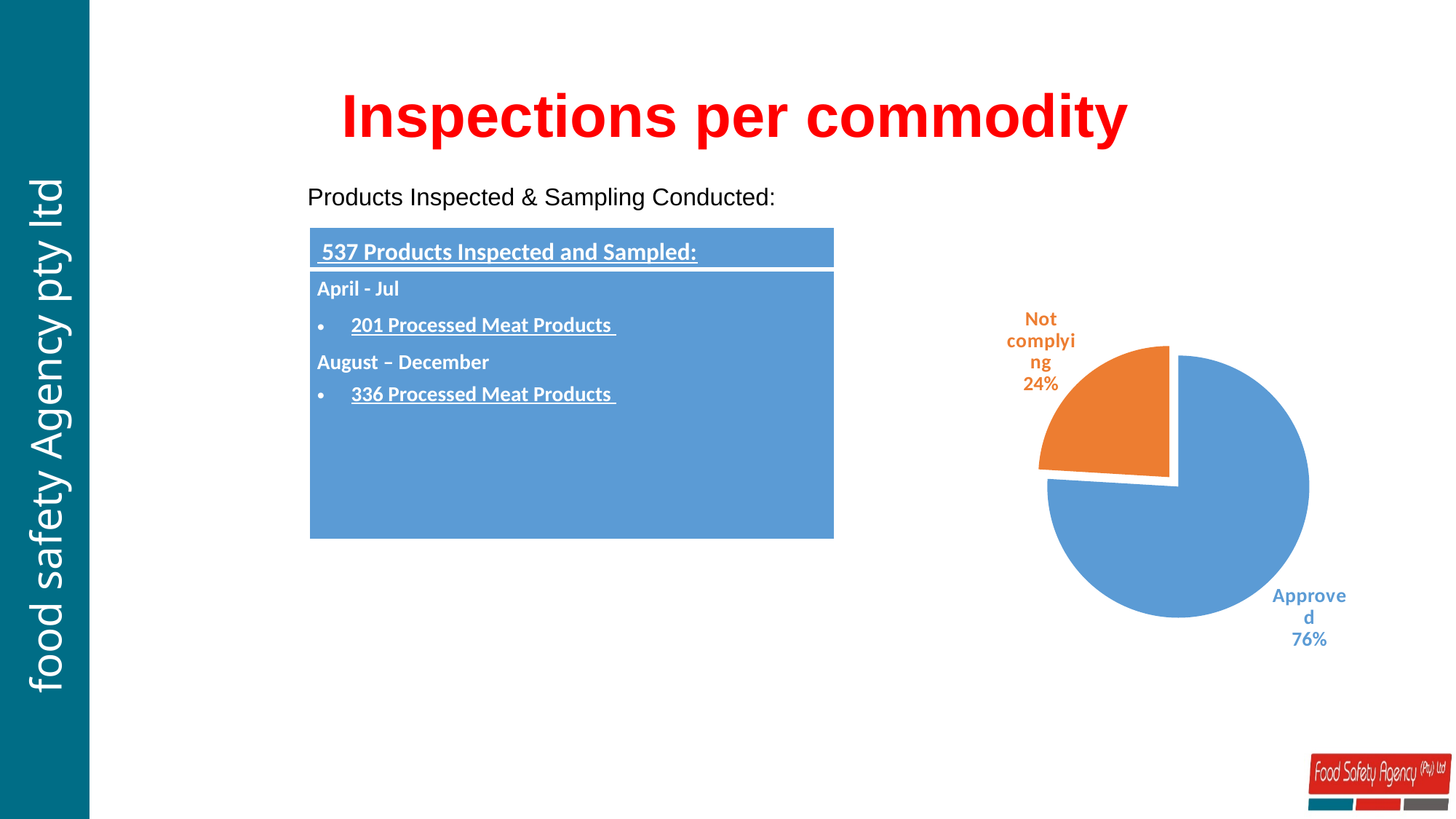
What kind of chart is shown on the slide? pie chart Which slice of the pie is the largest? Approved What share of the pie is labelled Approved? 76% How many slices does the pie chart have? 2 What colour is the Approved slice of the pie? blue Which is larger, the Approved slice or the Not complying slice? Approved What colour is the Not complying slice of the pie? orange What is the difference in percentage points between the Approved and Not complying slices? 52 What share of the pie is labelled Not complying? 24% Which slice of the pie is the smallest? Not complying